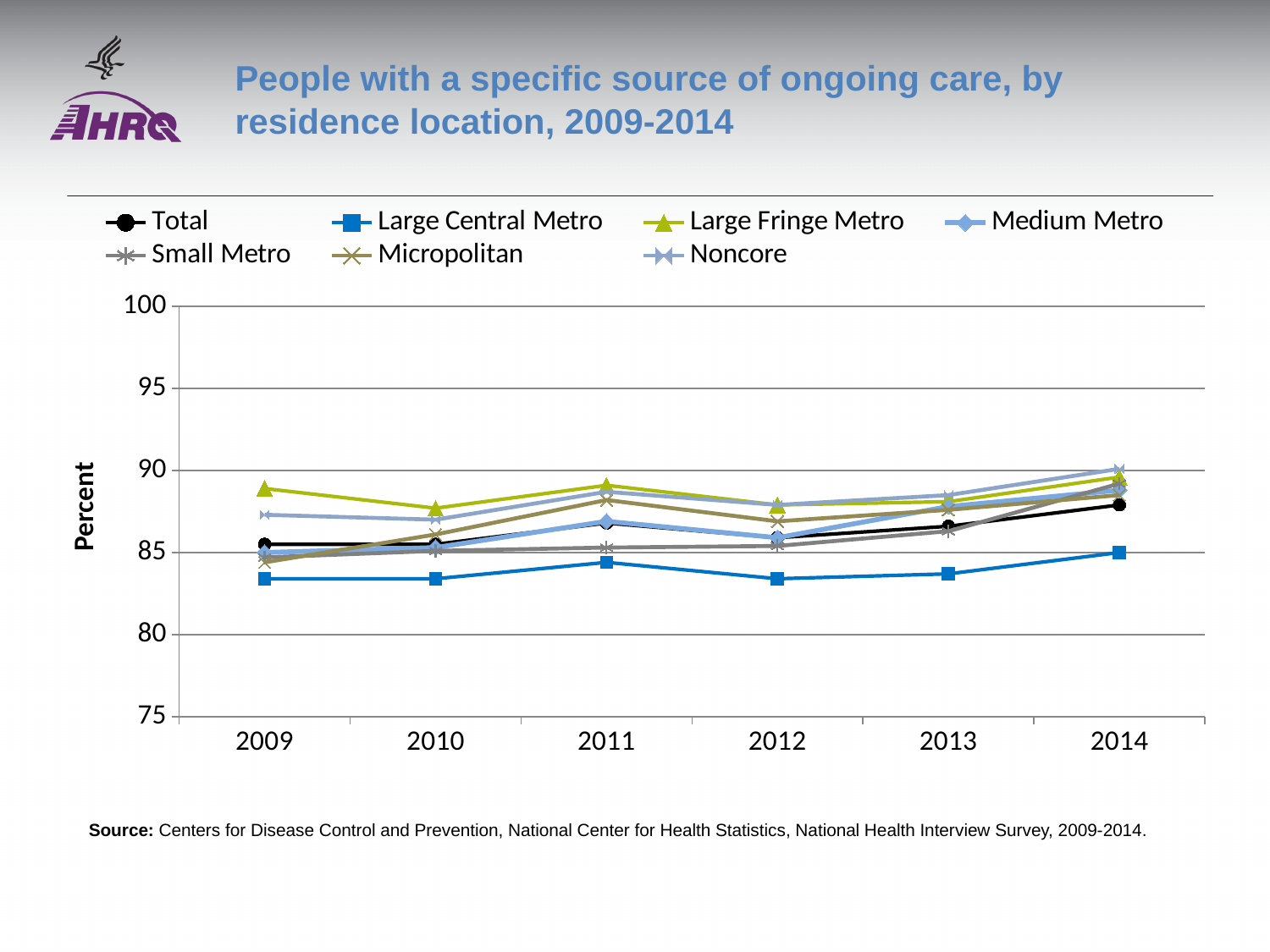
In 2012, which is larger: Large Fringe Metro or Large Central Metro? Large Fringe Metro Which residence location has the lowest value in 2014? Large Central Metro What kind of chart is shown on the slide? Line chart Which residence location has the highest value in 2009? Large Fringe Metro How many years are shown on the x axis? 6 What is the label on the y axis? Percent Is the value for Large Central Metro in 2009 greater or less than 85? less Is the value for Noncore in 2011 greater or less than 85? greater Which residence location has the lowest value in 2009? Large Central Metro How many series does the legend list? 7 Does the Total line rise or fall from 2013 to 2014? Rise Is the value for Large Fringe Metro in 2009 greater or less than 90? less